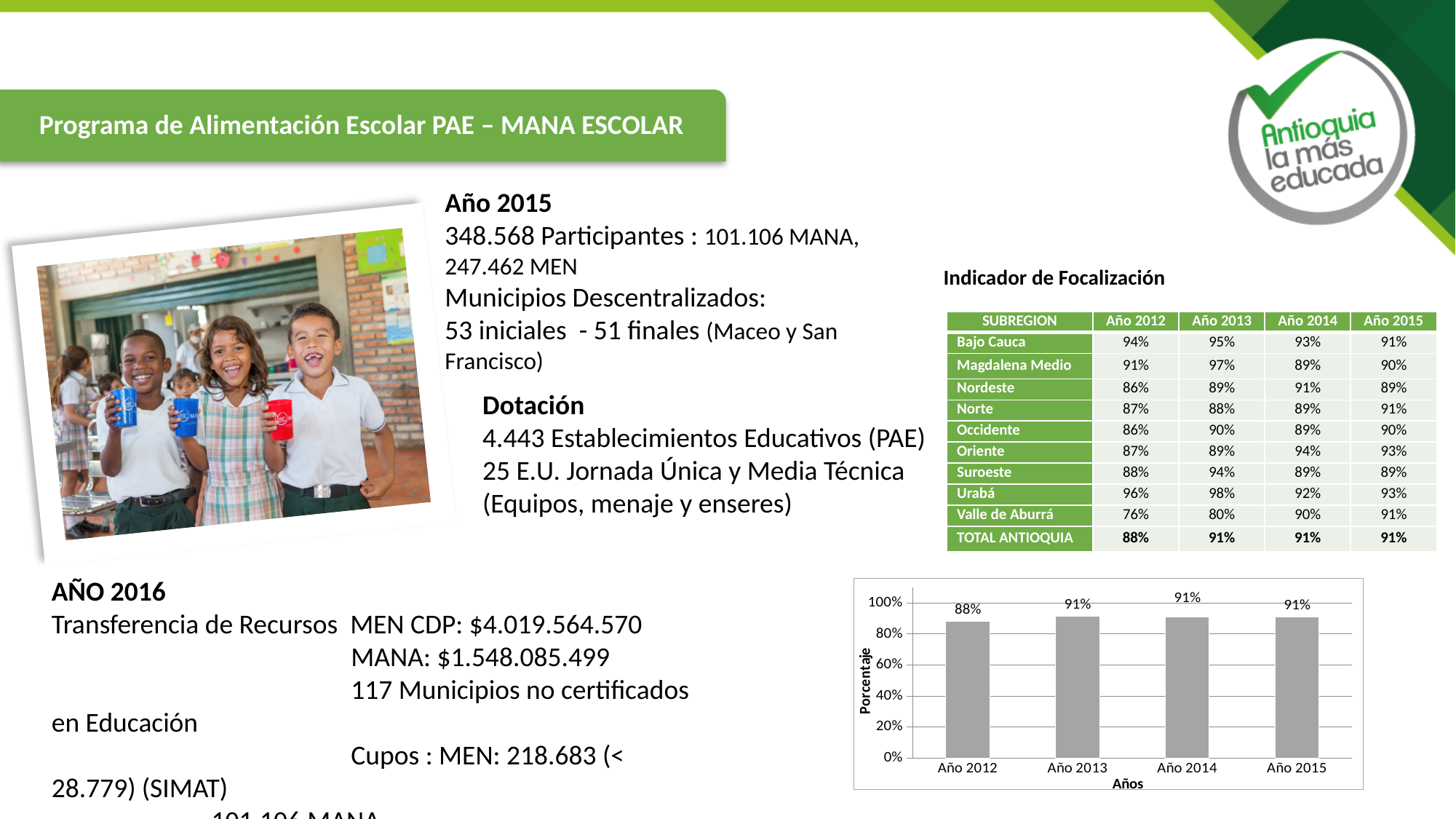
In the bar chart, what is the value for Año 2015? 91% In the bar chart, which is larger, the value for Año 2012 or the value for Año 2014? Año 2014 In the bar chart, does the value rise or fall from Año 2012 to Año 2013? rise In the bar chart, what is the value for Año 2012? 88% In the bar chart, what is the difference between the value for Año 2013 and the value for Año 2012? 3% In the bar chart, which year has the lowest value? Año 2012 How many bars are plotted in the bar chart? 4 In the bar chart, is the value for Año 2012 greater or less than 80%? greater What kind of chart is shown at the bottom right of the slide? bar chart In the bar chart, what is the value for Año 2013? 91% What is the label of the vertical axis of the bar chart? Porcentaje What is the label of the horizontal axis of the bar chart? Años